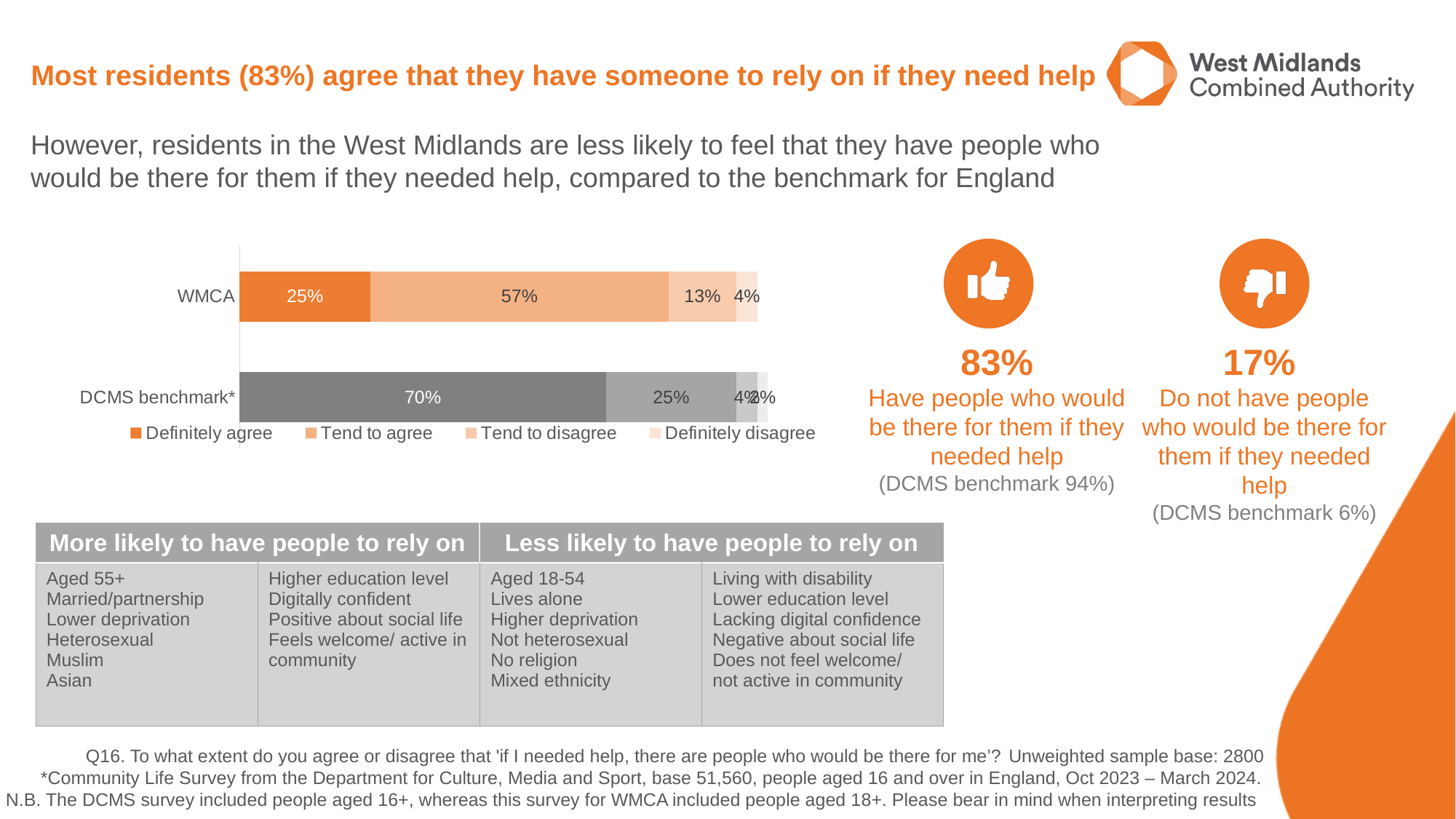
What percentage of WMCA residents 'Definitely agree' that they have people who would be there for them? 25% What type of chart is used to show the WMCA and DCMS benchmark* results? Stacked bar chart What is the 'Tend to agree' value for the DCMS benchmark*? 25% What is the 'Definitely agree' value for the DCMS benchmark* bar? 70% How many series does the chart legend list? 4 Which bar has the larger 'Definitely agree' share, WMCA or DCMS benchmark*? DCMS benchmark* What is the 'Tend to disagree' value for WMCA? 13% How many bars (categories) are shown in the chart? 2 What is the 'Definitely disagree' value for WMCA? 4% What is the 'Tend to agree' value for WMCA in the chart? 57% How many percentage points higher is the DCMS benchmark* 'Definitely agree' value than the WMCA 'Definitely agree' value? 45 percentage points Which response category is the largest segment of the WMCA bar? Tend to agree